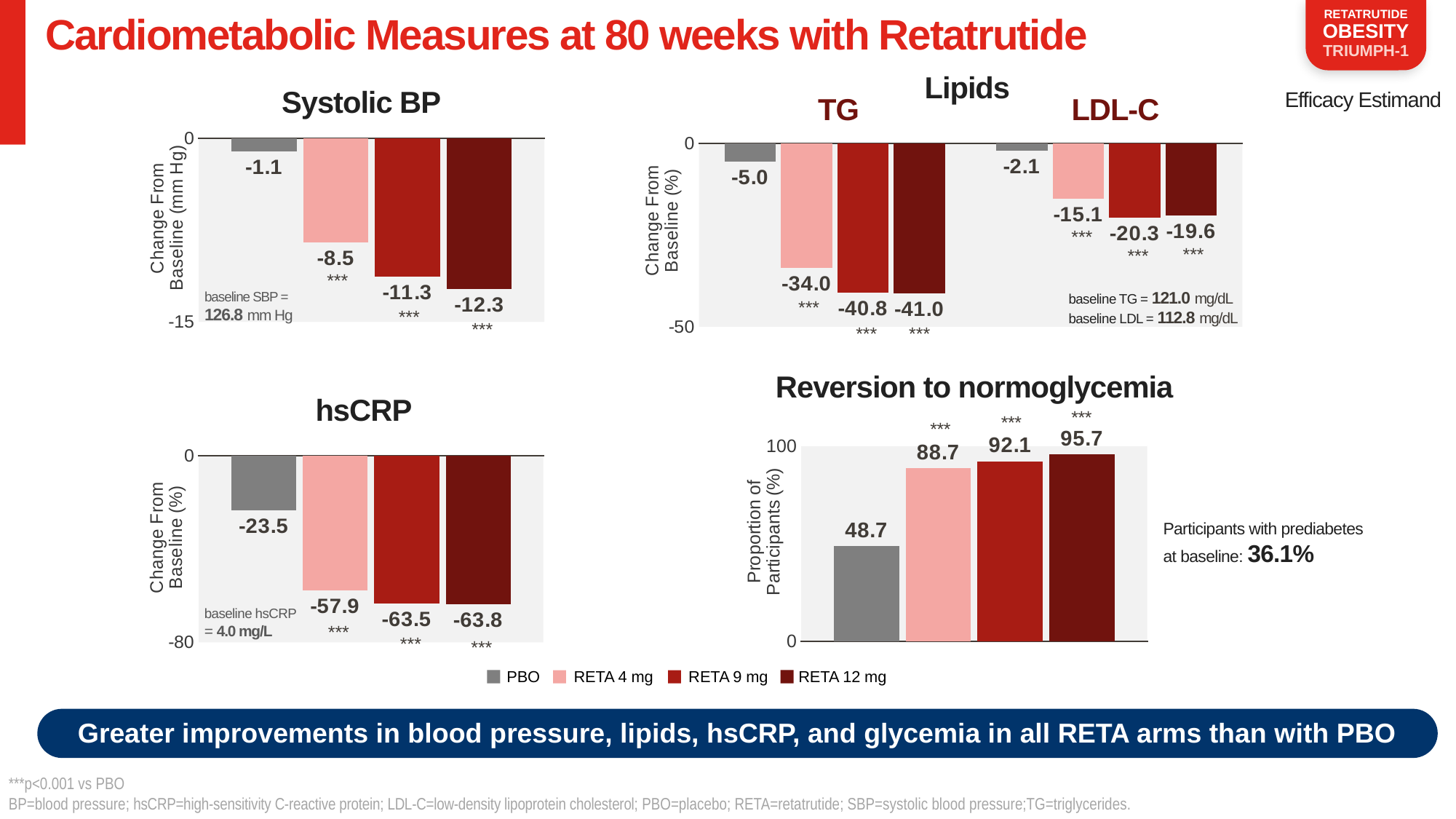
In the hsCRP chart, what is the difference between the RETA 12 mg and PBO changes from baseline? 40.3 In the Lipids chart, what is the LDL-C change from baseline for RETA 9 mg? -20.3 What kind of chart is the hsCRP chart? Bar chart In the Systolic BP chart, what is the change from baseline for PBO? -1.1 In the Systolic BP chart, what is the change from baseline for RETA 12 mg? -12.3 In the Reversion to normoglycemia chart, what is the difference between the RETA 12 mg and PBO proportions? 47.0 In the Lipids chart, what is the TG change from baseline for RETA 4 mg? -34.0 In the Reversion to normoglycemia chart, which arm has the lowest proportion of participants? PBO In the Reversion to normoglycemia chart, what proportion of participants on RETA 9 mg reverted to normoglycemia? 92.1 How many series does the shared legend list? 4 In the hsCRP chart, what is the change from baseline for RETA 4 mg? -57.9 In the Lipids chart, which arm has the largest TG reduction from baseline? RETA 12 mg